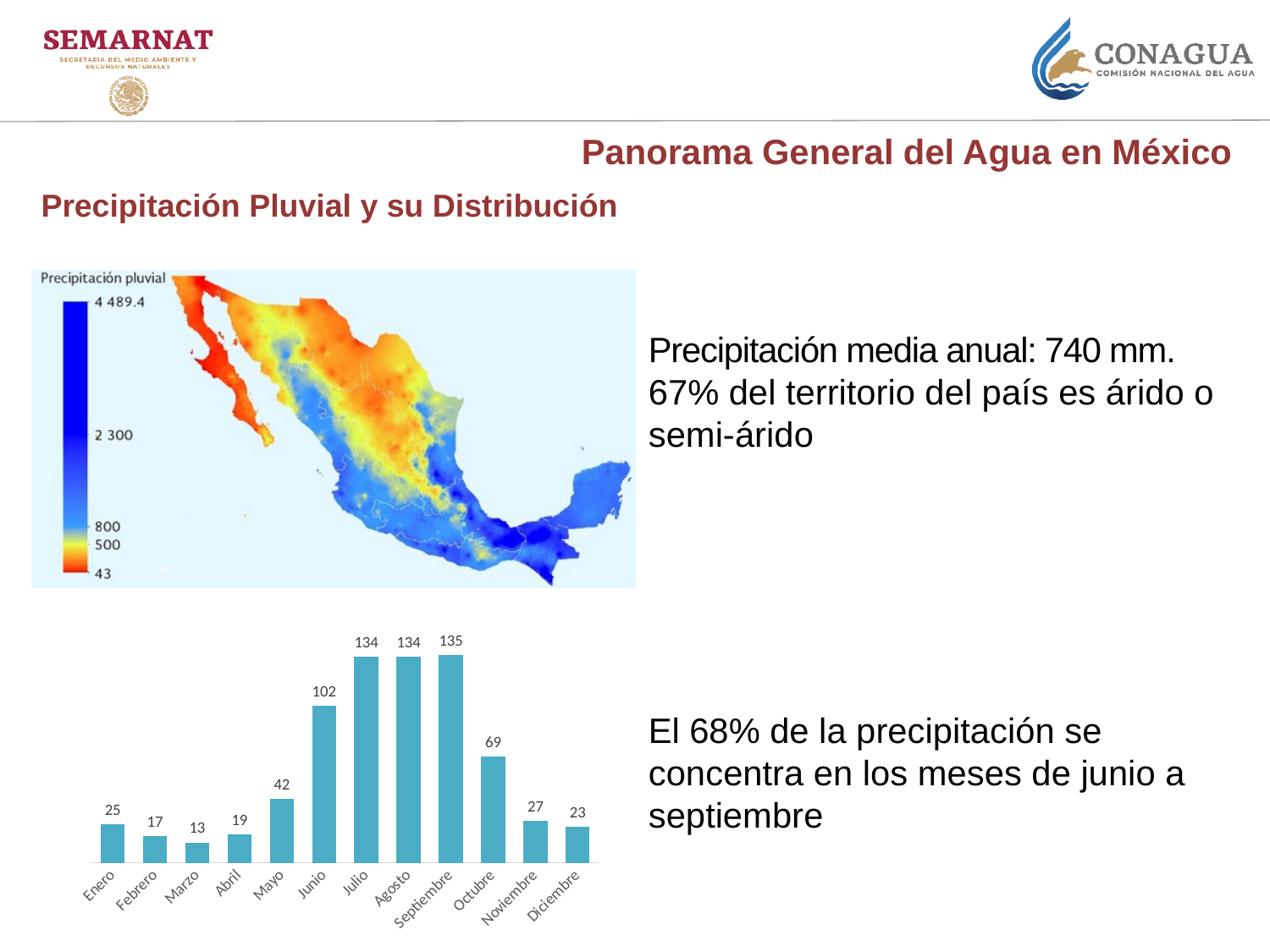
In the bar chart, which month has the lowest value? Marzo In the bar chart, what is the value for Enero? 25 In the bar chart, what is the value for Junio? 102 In the bar chart, which is larger, the value for Noviembre or the value for Diciembre? Noviembre In the bar chart, which month has the highest value? Septiembre What kind of chart is shown at the bottom left of the slide? Bar chart In the bar chart, what is the value for Octubre? 69 In the bar chart, what is the difference between the values for Septiembre and Octubre? 66 How many months are shown in the bar chart? 12 In the bar chart, what is the difference between the values for Junio and Mayo? 60 In the bar chart, do the values rise or fall from Septiembre to Diciembre? Fall In the bar chart, which is larger, the value for Febrero or the value for Abril? Abril